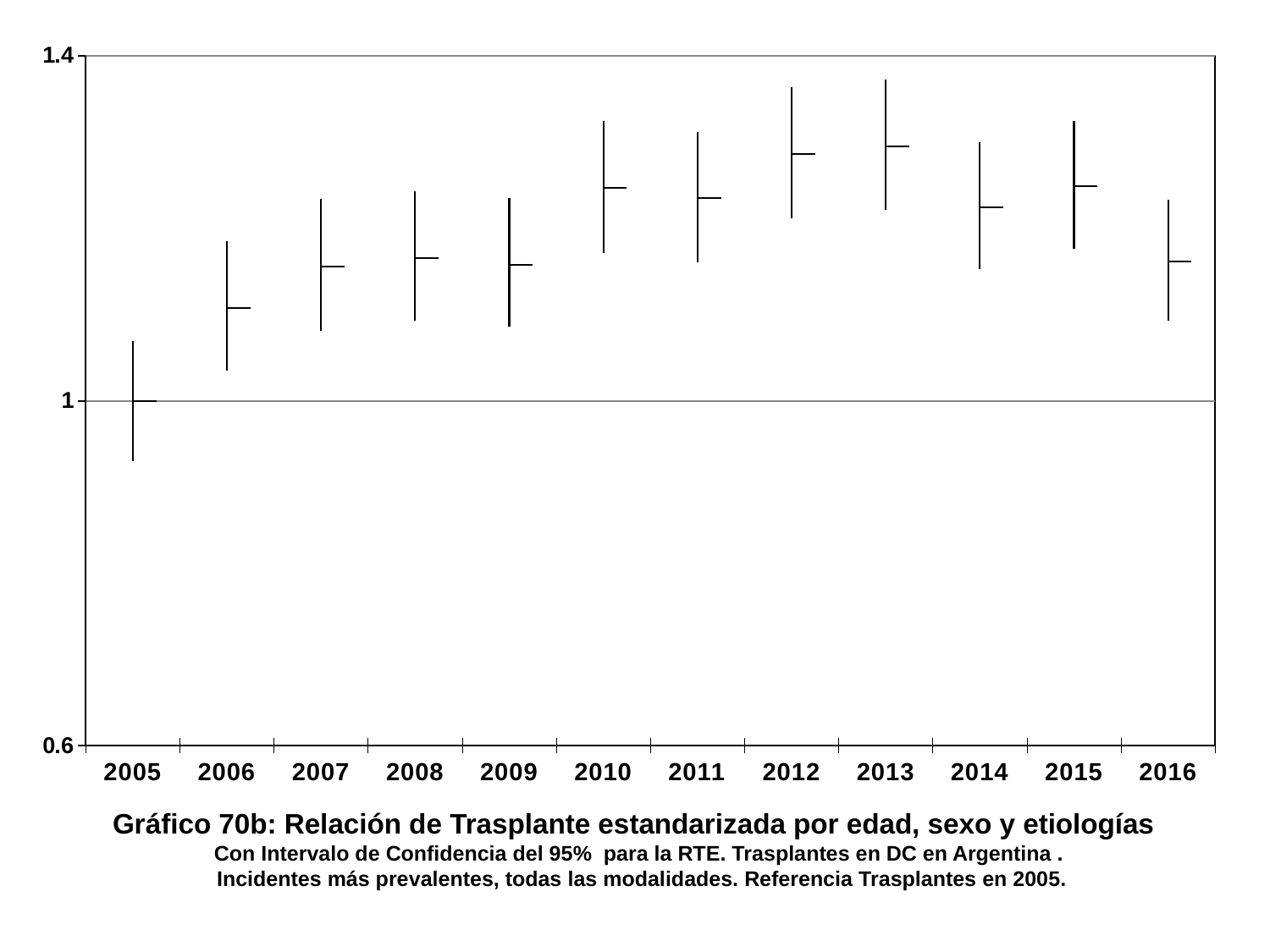
What is the value of the standardized transplant ratio (RTE) for 2005, the reference year? 1 What are the minimum and maximum values shown on the y axis? 0.6 and 1.4 Which year has the larger point estimate, 2006 or 2010? 2010 How many years are shown on the x axis of the chart? 12 Which year has the lowest point estimate in the chart? 2005 Which year has the larger point estimate, 2012 or 2014? 2012 What is the title of the chart? Gráfico 70b: Relación de Trasplante estandarizada por edad, sexo y etiologías Do the point estimates generally rise or fall from 2005 to 2013? rise Is the point estimate for 2012 greater or less than 1.4? less Is the point estimate for 2013 greater or less than 1? greater Which year has the larger point estimate, 2009 or 2015? 2015 Is the point estimate for 2016 greater or less than 1? greater